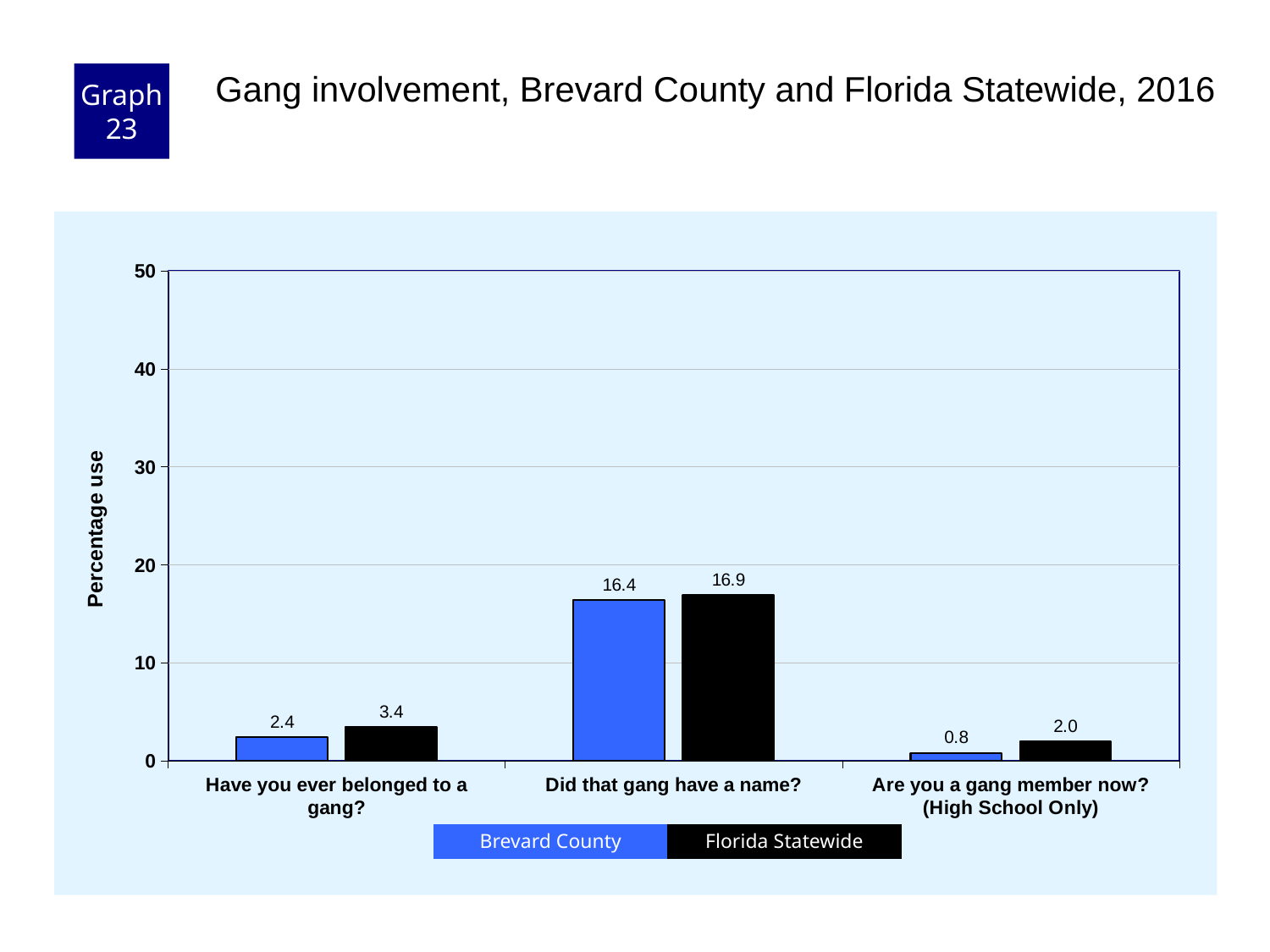
For "Have you ever belonged to a gang?", which is larger: Brevard County or Florida Statewide? Florida Statewide What kind of chart is shown on the slide? Bar chart What is the difference between the Florida Statewide and Brevard County values for "Are you a gang member now? (High School Only)"? 1.2 How many questions (categories) are shown on the x axis? 3 What is the Brevard County value for "Did that gang have a name?"? 16.4 What is the Brevard County value for "Are you a gang member now? (High School Only)"? 0.8 Which question has the highest Florida Statewide value? Did that gang have a name? What is the Florida Statewide value for "Have you ever belonged to a gang?"? 3.4 Which question has the lowest Brevard County value? Are you a gang member now? (High School Only) Is the Florida Statewide value for "Did that gang have a name?" greater or less than 20? less What is the label of the y axis? Percentage use How many series does the legend list? 2